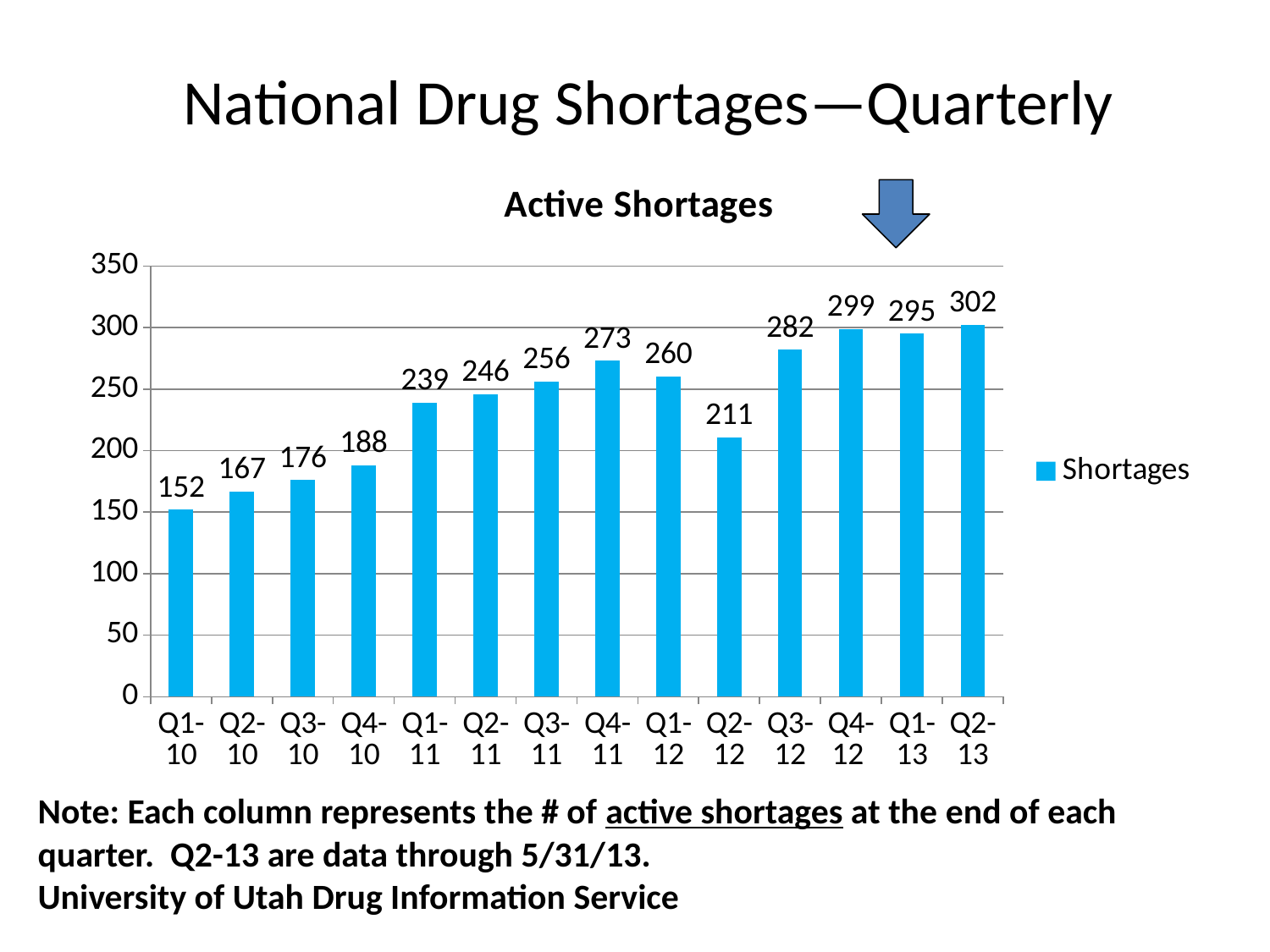
How many quarters are shown on the x axis? 14 What is the value for Q1-10? 152 Which quarter has the highest number of active shortages? Q2-13 What kind of chart is this? bar chart What is the title of the chart? Active Shortages What is the value for Q2-12? 211 What is the difference between the values for Q1-12 and Q2-12? 49 What is the value for Q4-12? 299 Is the value for Q3-11 greater or less than 250? greater Which is larger, the value for Q4-12 or the value for Q1-13? Q4-12 Which quarter has the lowest number of active shortages? Q1-10 What is the difference between the values for Q2-13 and Q1-10? 150